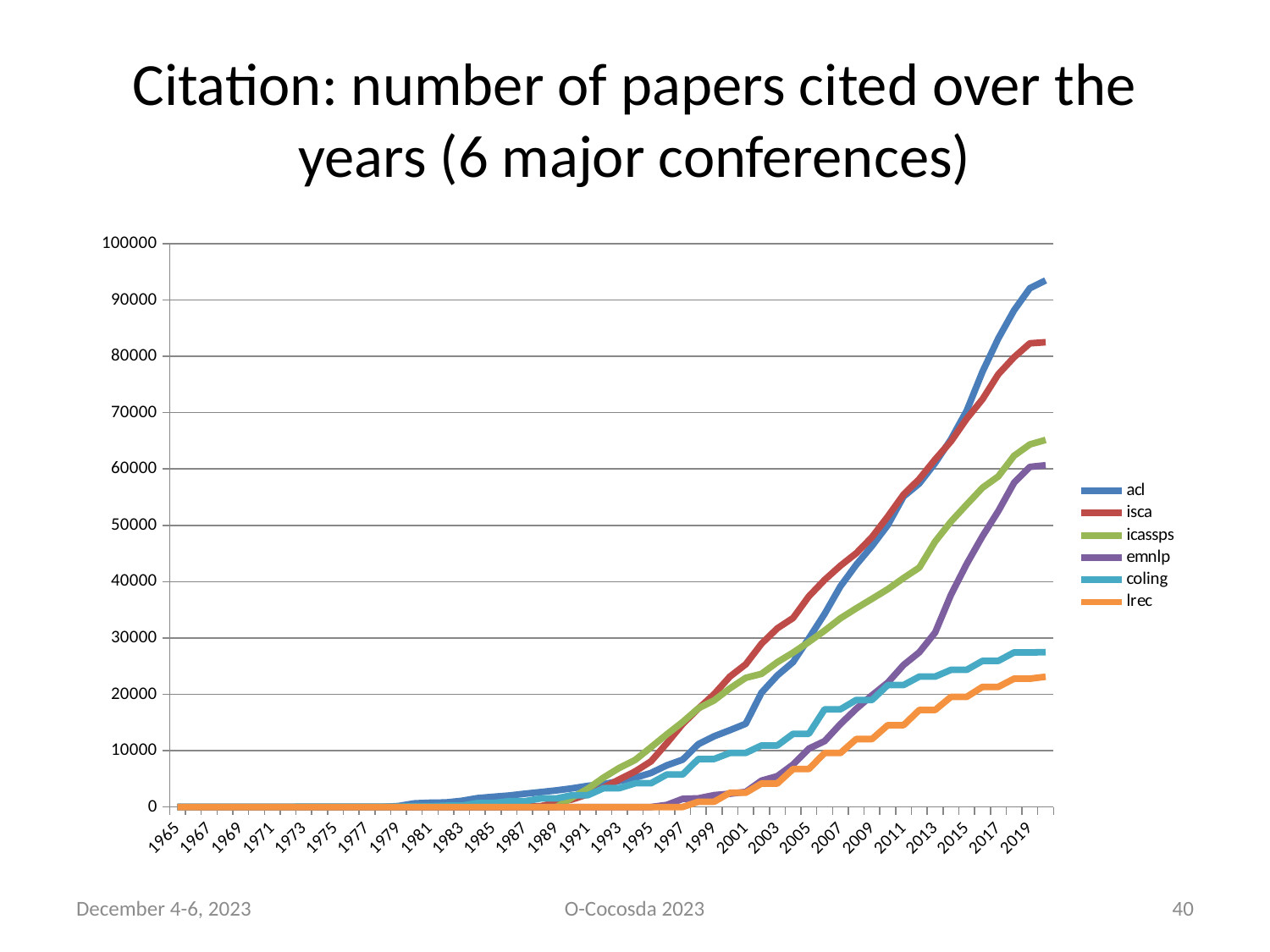
In 2003, which is larger, the value for isca or the value for acl? isca Do the values for acl rise or fall from 1995 to 2019? rise Which series has the lowest value in 2019? lrec In 2019, which is larger, the value for acl or the value for isca? acl Is the value for icassps in 2019 greater or less than 60000? greater Is the value for isca in 2019 greater or less than 70000? greater How many series does the legend list? 6 Is the value for acl in 2019 greater or less than 80000? greater Which series is drawn in orange? lrec Which series has the highest value in 2019? acl What kind of chart is shown on the slide? line chart